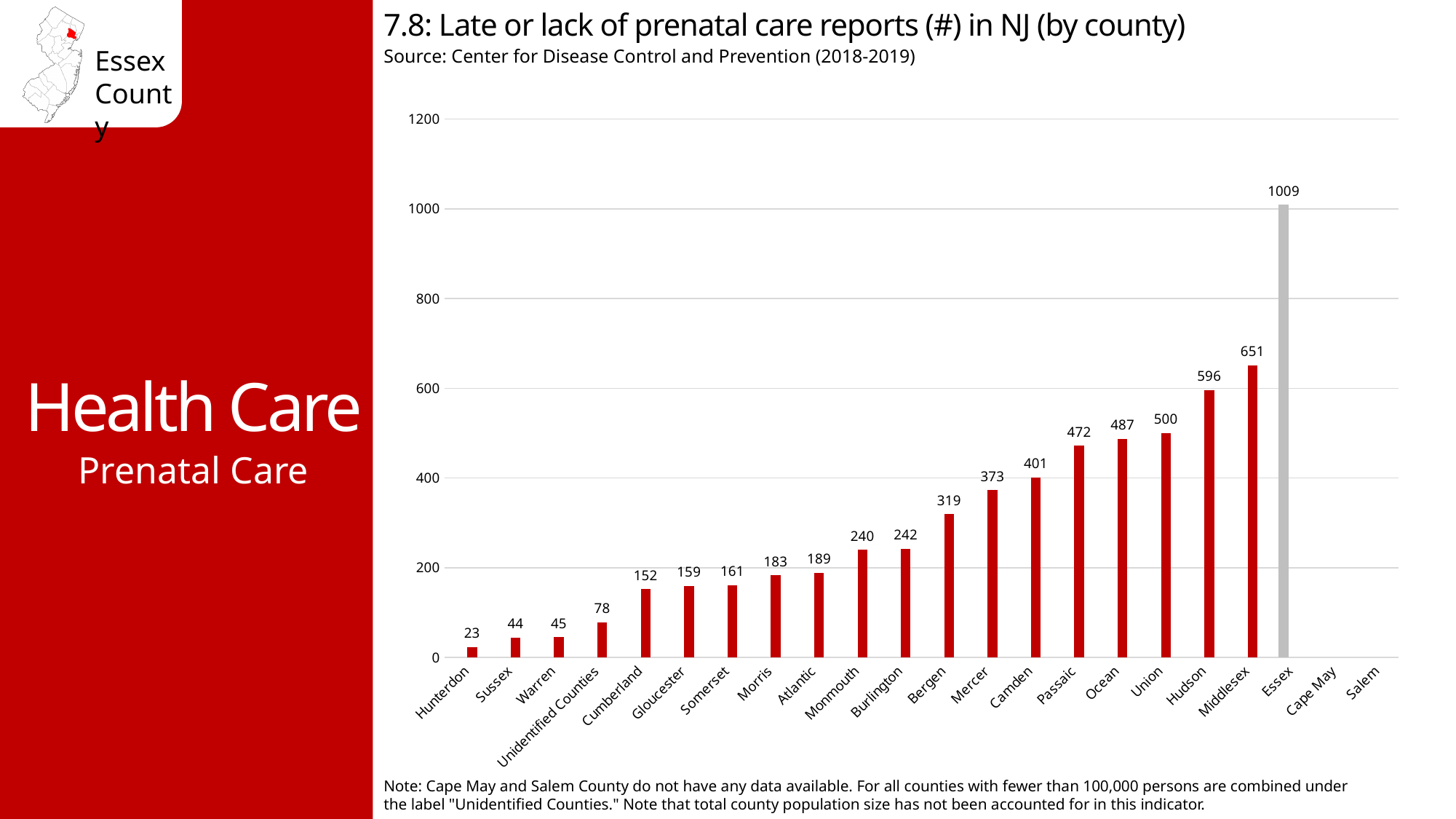
What is the number of late or lack of prenatal care reports for Essex? 1009 Which county with a plotted bar has the lowest number of reports? Hunterdon How many categories are listed on the x axis? 22 Which bar is coloured grey instead of red? Essex Which has a larger value, Bergen or Mercer? Mercer Is the value for Union greater or less than 400? greater Do the values generally rise or fall from Hunterdon to Essex along the x axis? rise What is the difference between the values for Essex and Middlesex? 358 Which county has the highest number of reports? Essex What is the value shown for Hudson? 596 What kind of chart is shown on the slide? bar chart What is the value shown for Unidentified Counties? 78